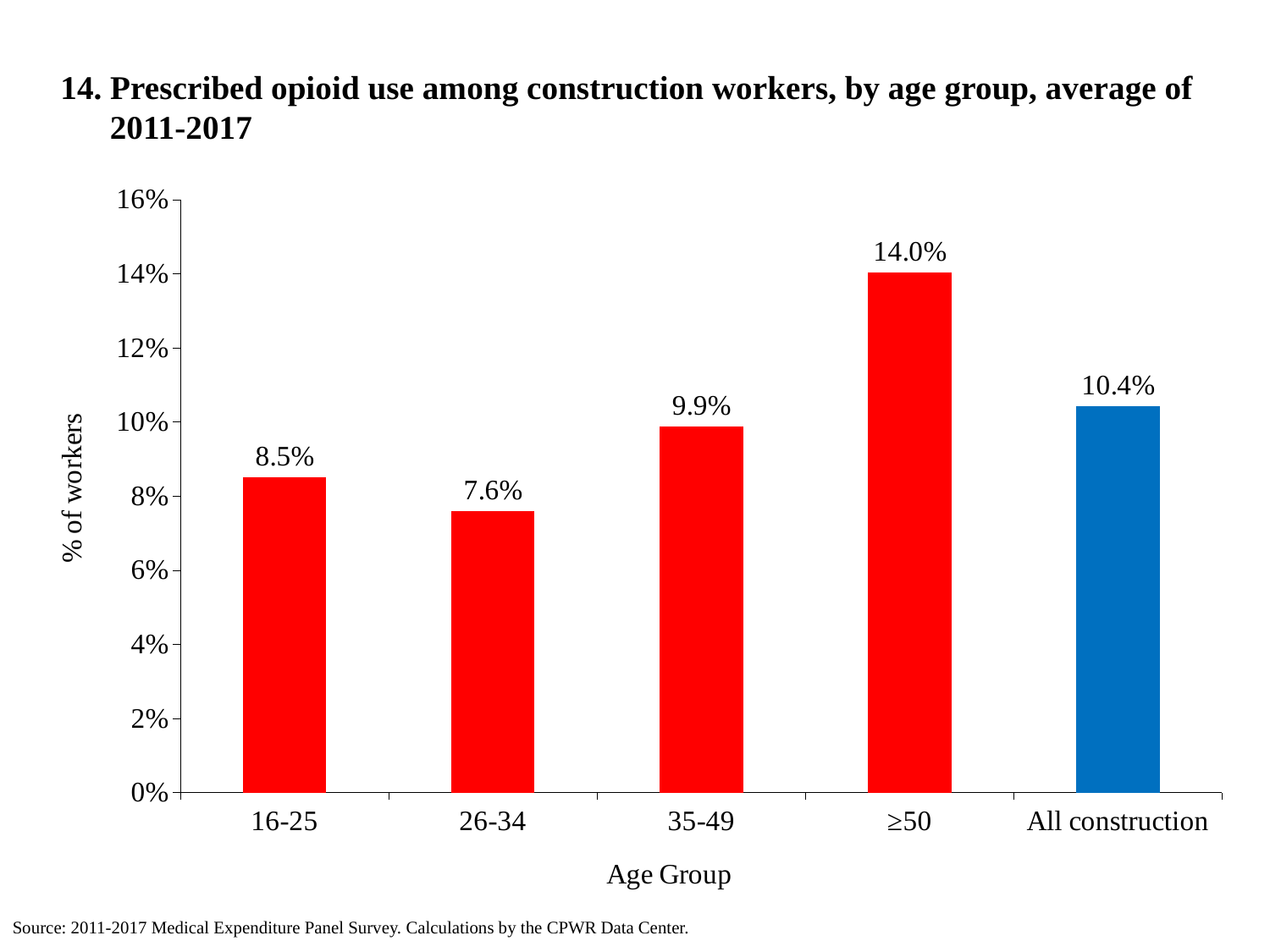
What is the value shown for the 35-49 age group? 9.9% What is the prescribed opioid use percentage for the 16-25 age group? 8.5% What is the difference between the ≥50 group and the 16-25 group? 5.5% How many categories are shown on the x axis? 5 Which age group has the highest prescribed opioid use? ≥50 Which category has the lowest value on the chart? 26-34 Is the value for the ≥50 age group greater or less than 12%? greater What is the value shown for All construction? 10.4% What type of chart is shown on the slide? Bar chart What is the label of the y axis? % of workers What is the value shown for the 26-34 age group? 7.6% Which is larger, the value for 35-49 or the value for All construction? All construction